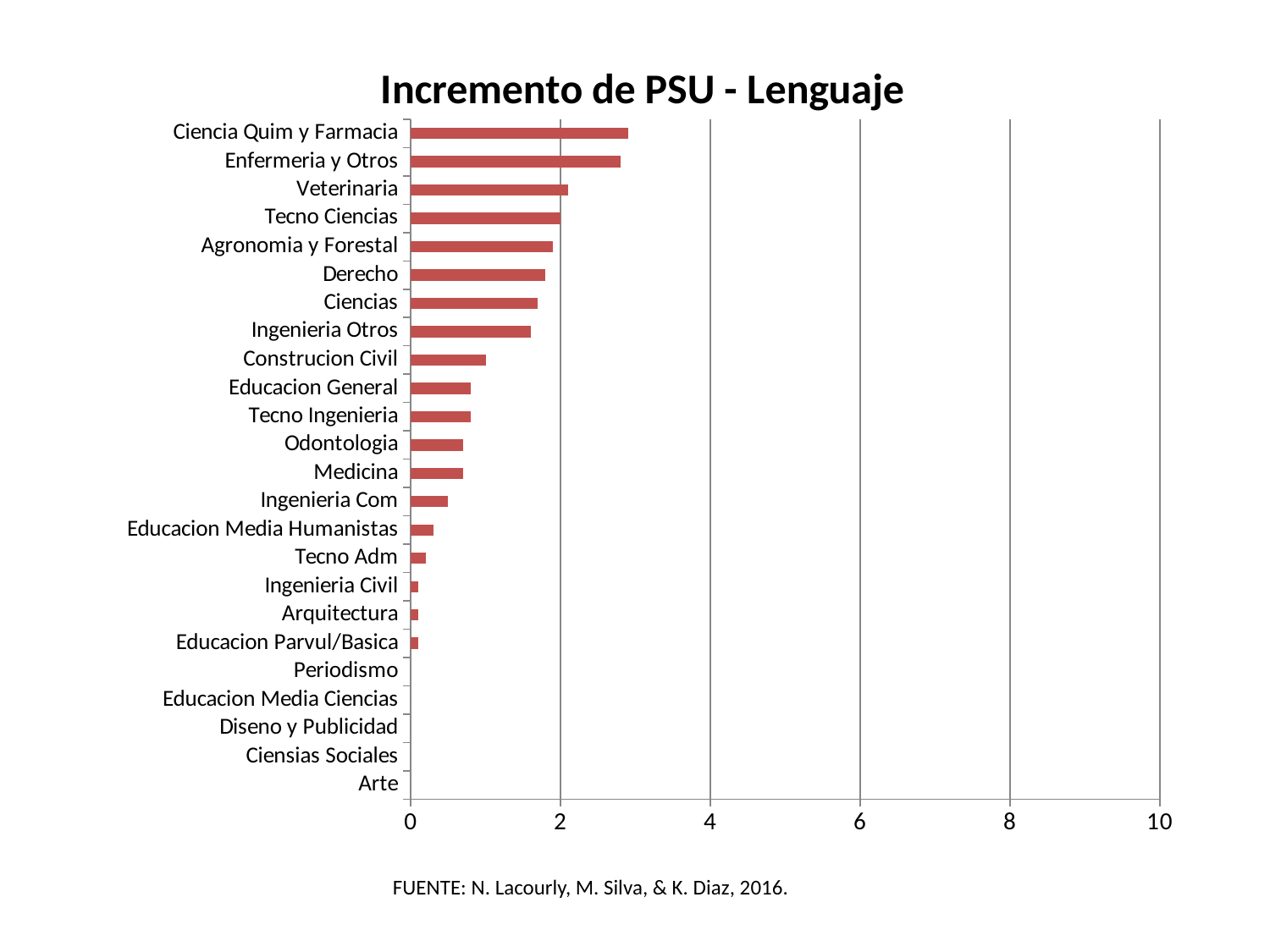
Is the value for Enfermeria y Otros greater or less than 2? greater Is the value for Derecho greater or less than 4? less What kind of chart is shown on the slide? bar chart Which has a larger value, Construcion Civil or Ingenieria Otros? Ingenieria Otros Going from the top category to the bottom category, do the bars get longer or shorter? shorter What is the highest value shown on the horizontal axis? 10 What is the title of the chart? Incremento de PSU - Lenguaje Which has a larger value, Derecho or Tecno Adm? Derecho How many categories are plotted in the chart? 24 Is the value for Construcion Civil greater or less than 2? less Which has a larger value, Ciencia Quim y Farmacia or Veterinaria? Ciencia Quim y Farmacia